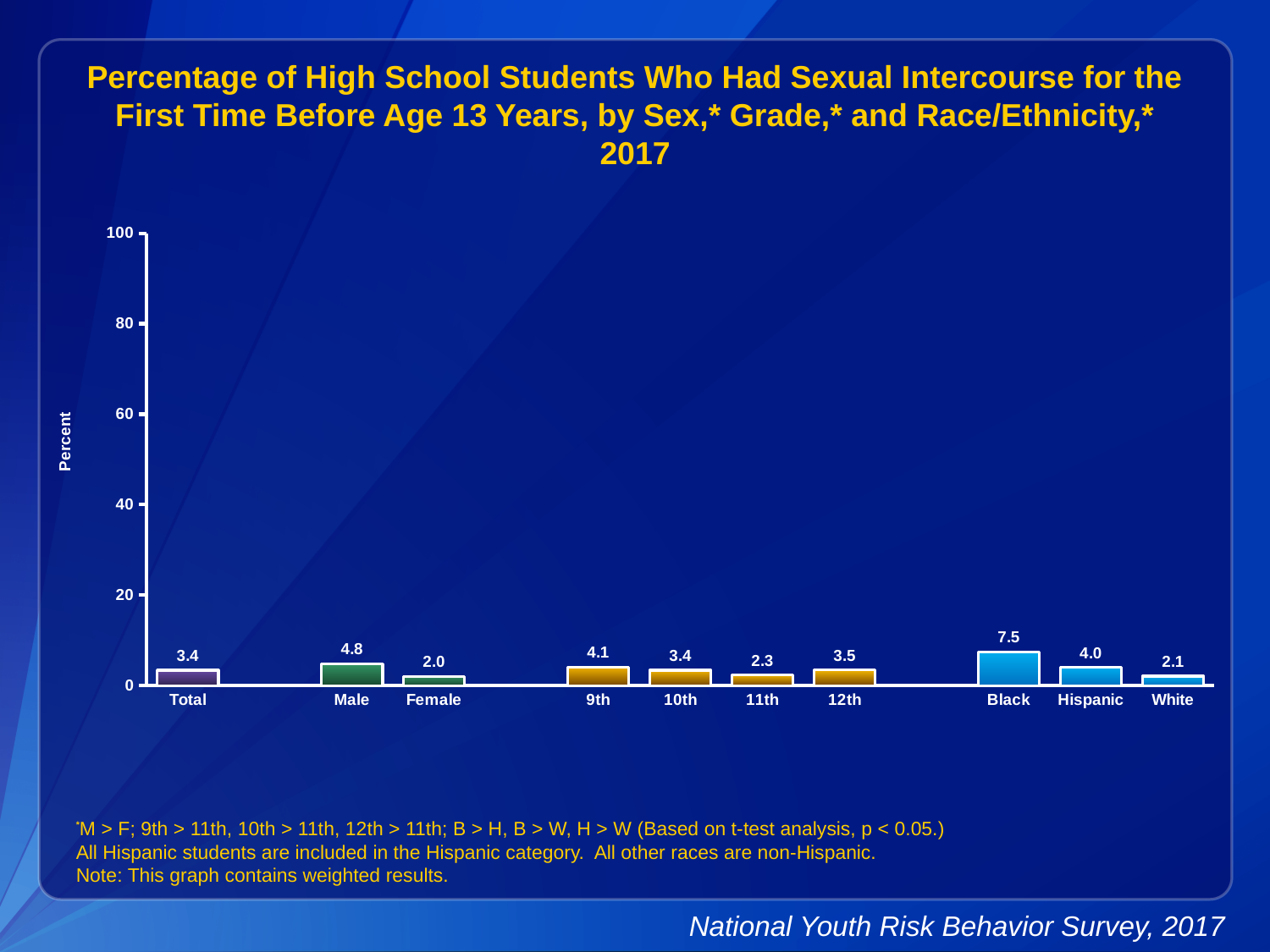
What is the value for Female? 2.0 What is the value for Total? 3.4 What is the value for Male? 4.8 Is the value for Black students greater or less than 20? less Which category has the highest value? Black Which is larger, the value for 9th grade or 12th grade? 9th How many bars are shown in the chart? 10 What is the value for Black students? 7.5 What is the difference between the values for Male and Female? 2.8 What is the value for 11th grade? 2.3 What kind of chart is shown? Bar chart Which category has the lowest value? Female